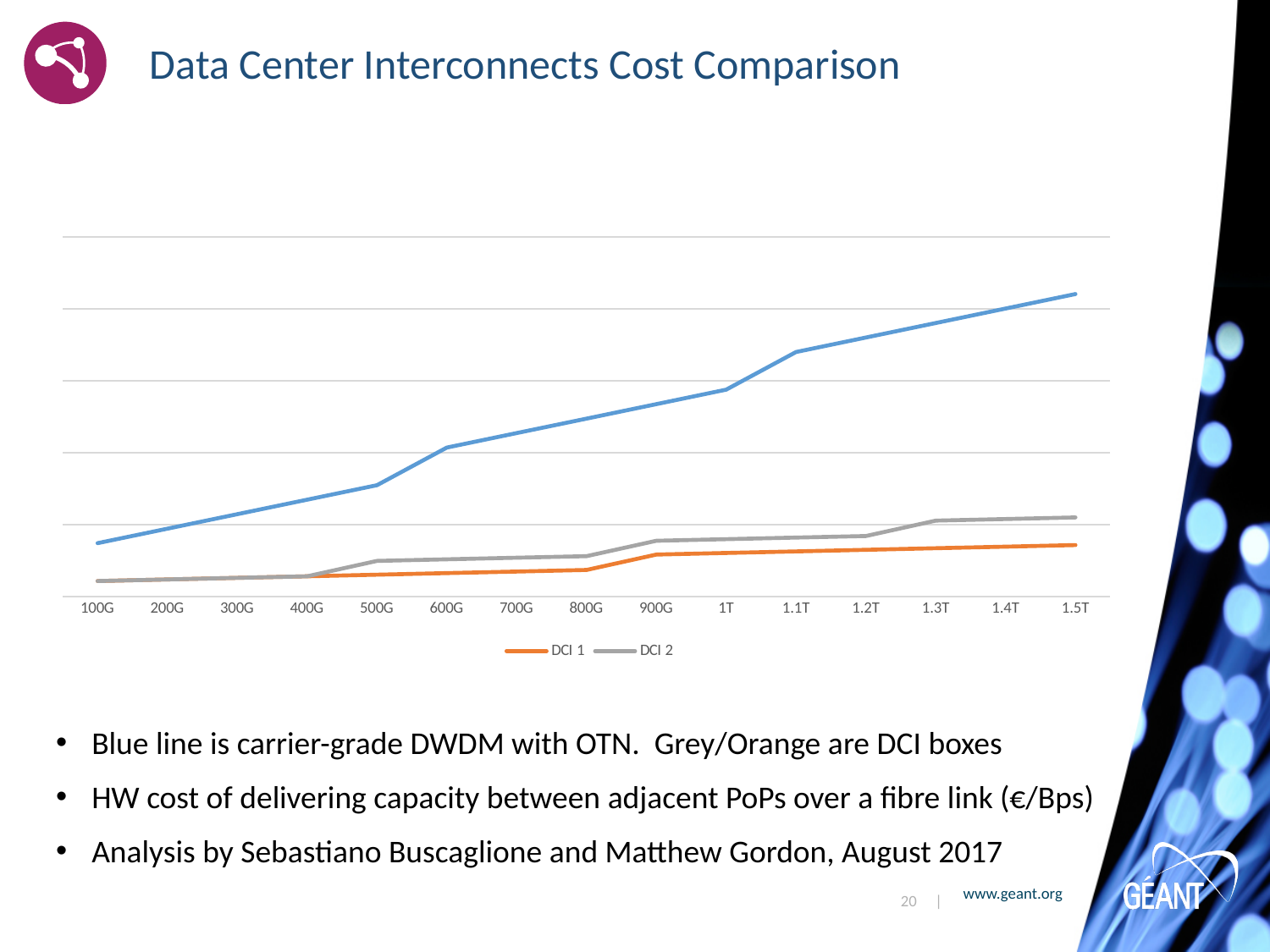
Does the blue line rise or fall as capacity increases from 100G to 1.5T? rises At 1T, which is higher, the blue line or DCI 2? the blue line How many series does the chart's legend list? 2 Which two series are named in the chart's legend? DCI 1 and DCI 2 At 1.3T, which is higher, DCI 1 or DCI 2? DCI 2 How many capacity points are labelled along the x axis of the chart? 15 What kind of chart is shown on the slide? line chart At 1.5T, which line is lowest: the blue line, DCI 1 or DCI 2? DCI 1 Does the DCI 2 line rise or fall from 100G to 1.5T? rises What is the first capacity label on the x axis of the chart? 100G What colour is the DCI 1 line in the chart? orange At 1.5T, which line is highest: the blue line, DCI 1 or DCI 2? the blue line